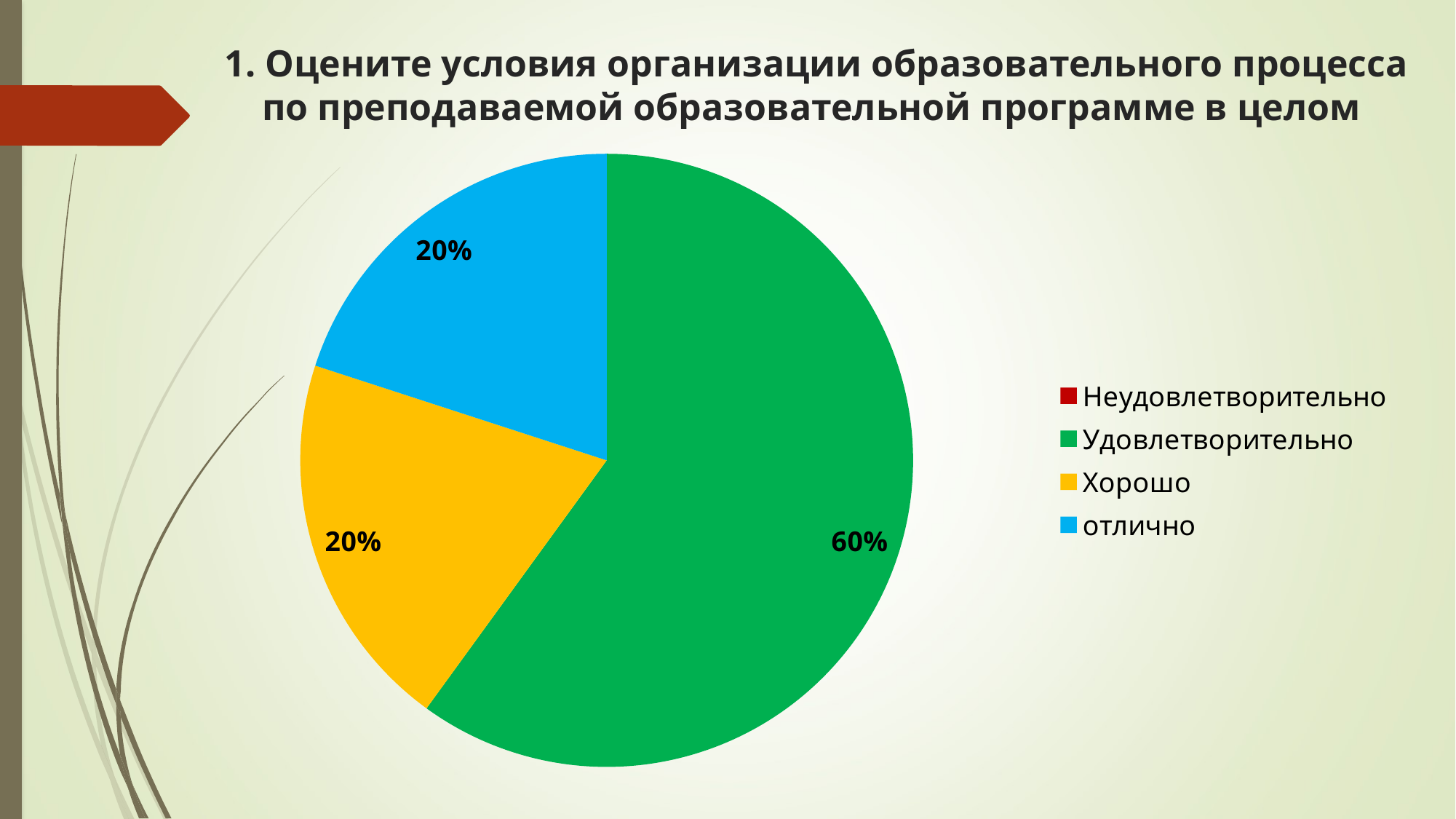
Which category has the largest slice of the pie? Удовлетворительно How many slices are visible in the pie chart? 3 Which is larger, the slice for "Удовлетворительно" or the slice for "Хорошо"? Удовлетворительно What share of the pie does the "Удовлетворительно" slice represent? 60% Is the share for "Удовлетворительно" greater or less than 50%? greater How many entries does the legend list? 4 What kind of chart is shown on the slide? pie chart What share of the pie does the "Хорошо" slice represent? 20% Which legend entry has no visible slice in the pie? Неудовлетворительно What share of the pie does the "отлично" slice represent? 20% What is the difference between the share for "Удовлетворительно" and the share for "отлично"? 40% What colour is the slice for "отлично"? blue